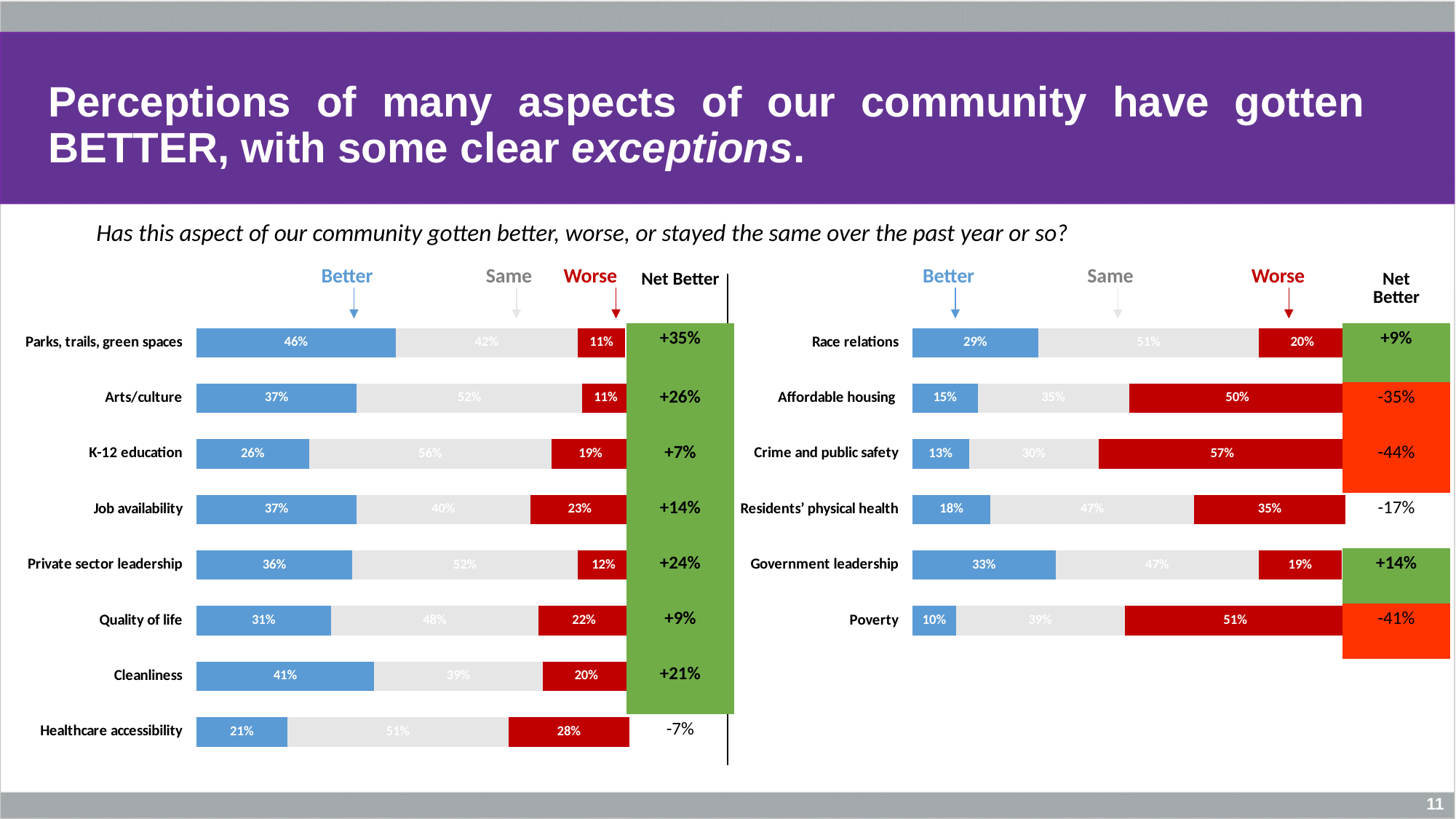
How many aspects are listed in the right chart? 6 In the left chart, which aspect has the lowest 'Better' percentage? Healthcare accessibility In the right chart, what is the difference between the 'Worse' and 'Better' percentages for Poverty? 41% What type of chart is used on this slide? Stacked bar chart In the left chart, which is larger: the 'Better' percentage for Cleanliness or for Quality of life? Cleanliness How many series (Better, Same, Worse) does each chart show? 3 In the right chart, what is the Net Better value for Government leadership? +14% In the right chart, which aspect has the highest 'Worse' percentage? Crime and public safety In the left chart, what percentage said parks, trails, green spaces have gotten better? 46% In the right chart, what percentage said crime and public safety has gotten worse? 57% In the left chart, what is the Net Better value for Healthcare accessibility? -7% How many aspects are listed in the left chart? 8